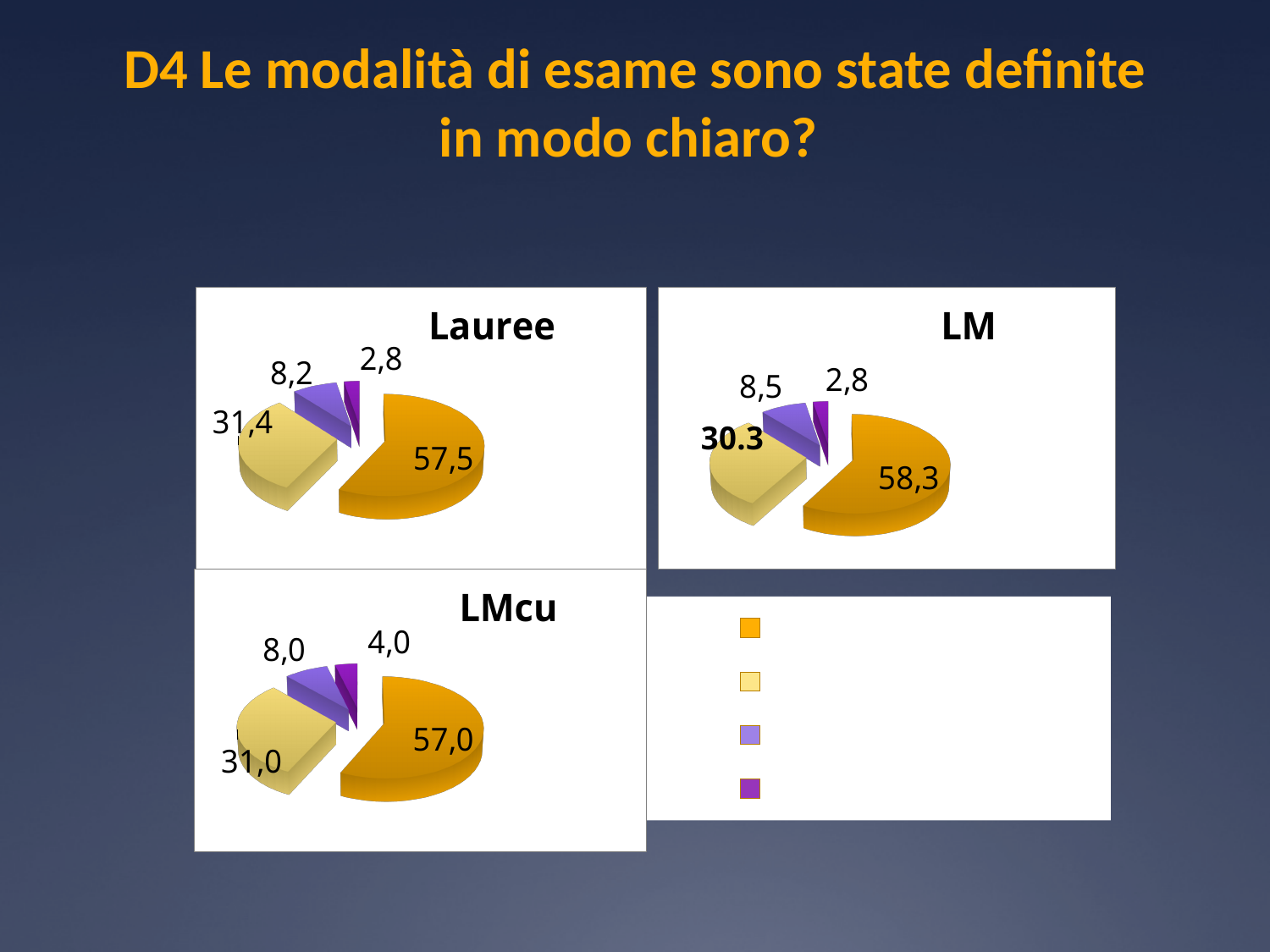
In the LM chart, what is the value of the orange slice? 58,3 In the Lauree chart, what is the difference between the orange slice (57,5) and the light yellow slice (31,4)? 26,1 In the LMcu chart, what is the value of the dark purple slice? 4,0 Which is larger: the dark purple slice in the LMcu chart or the dark purple slice in the Lauree chart? LMcu Across the three charts, which chart has the largest value for its orange slice? LM How many slices does the LM pie chart have? 4 How many colour swatches does the legend box at the bottom right show? 4 In the LMcu chart, what is the difference between the orange slice (57,0) and the light yellow slice (31,0)? 26,0 In the LM chart, what is the value of the light yellow slice? 30.3 In the LMcu chart, what is the value of the smallest slice? 4,0 What kind of chart is the Lauree chart? pie chart In the Lauree chart, what is the value of the largest slice? 57,5